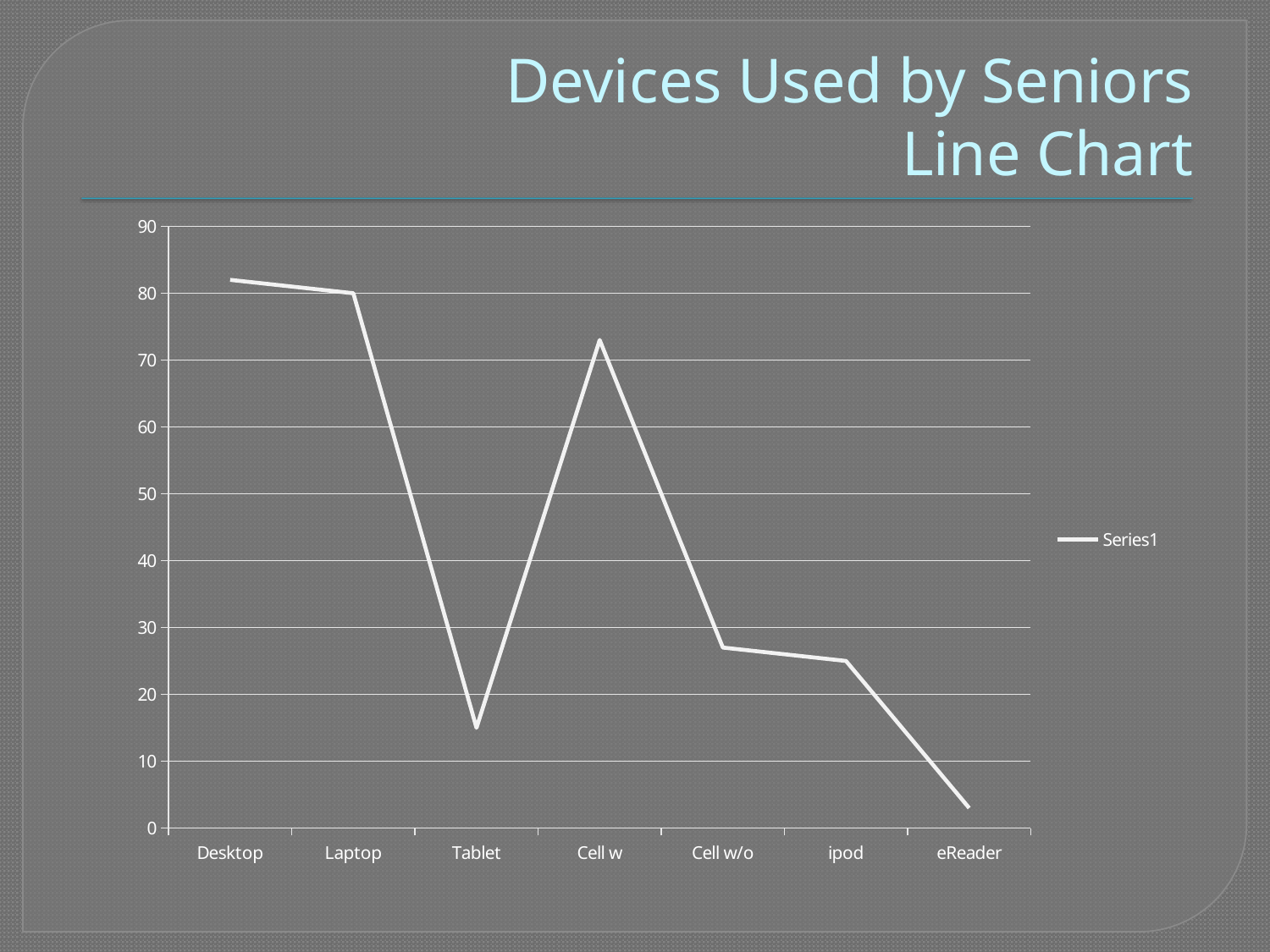
Does the line rise or fall from Cell w to eReader? fall Which has the larger value, Tablet or ipod? ipod Is the value for Cell w/o greater or less than 30? less What is the value for Laptop? 80 Is the value for Tablet greater or less than 20? less What is the name of the series shown in the legend? Series1 Which device has the lowest value? eReader How many device categories are plotted along the x axis? 7 What type of chart is shown on the slide? line chart How many series does the legend list? 1 Which has the larger value, Cell w or Cell w/o? Cell w Is the value for Desktop greater or less than 70? greater